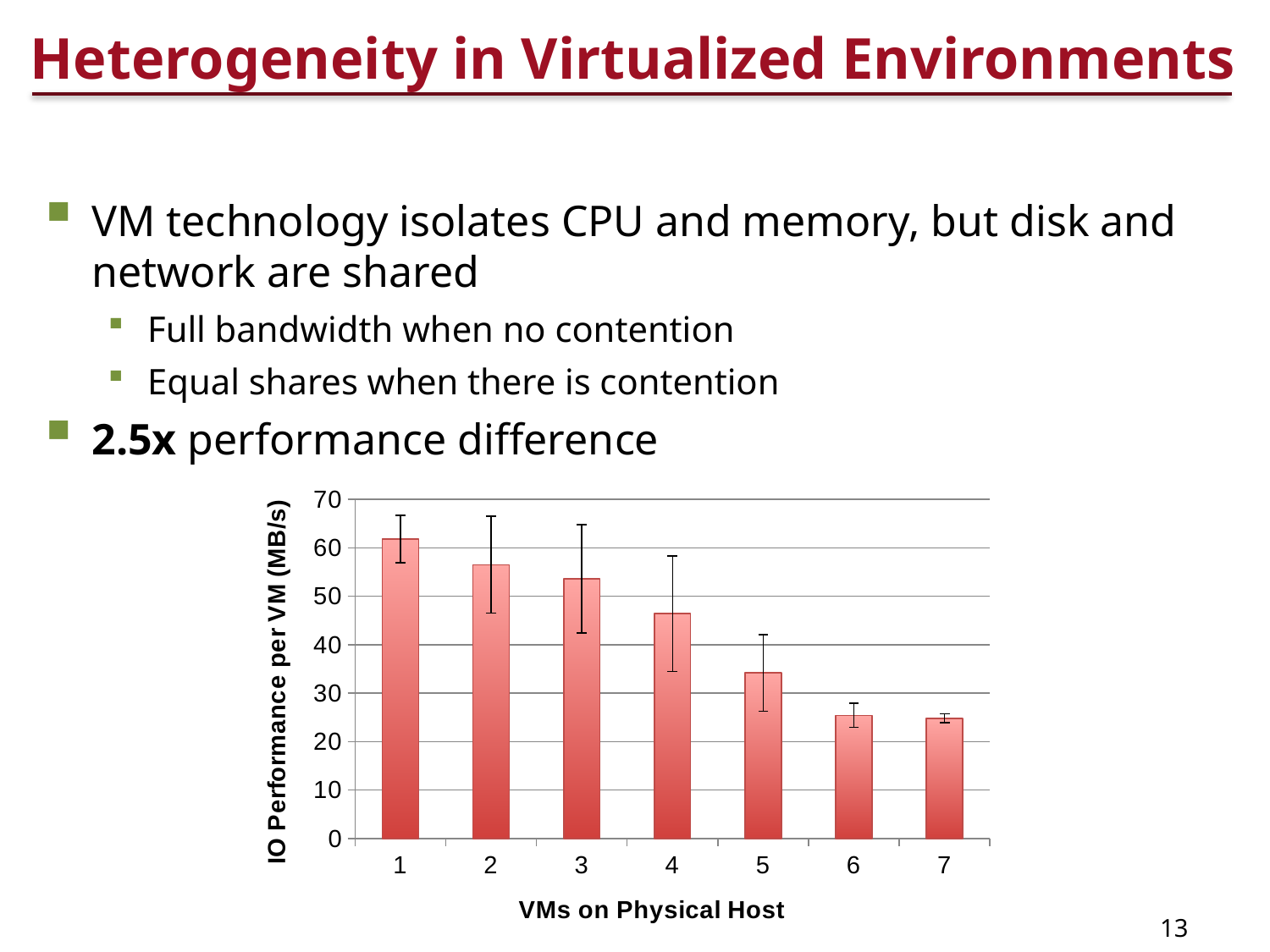
Do the values rise or fall as the number of VMs on the physical host increases from 1 to 7? fall Is the IO performance per VM for 6 VMs greater or less than 30 MB/s? less Which number of VMs on the physical host has the highest IO performance per VM? 1 What kind of chart is shown on the slide? bar chart How many bars (categories) are plotted in the chart? 7 Is the IO performance per VM for 5 VMs greater or less than 40 MB/s? less Is the IO performance per VM for 2 VMs greater or less than 50 MB/s? greater What is the label of the horizontal axis of the chart? VMs on Physical Host What is the label of the vertical axis of the chart? IO Performance per VM (MB/s) Which has a higher IO performance per VM: 2 VMs or 5 VMs on the physical host? 2 VMs